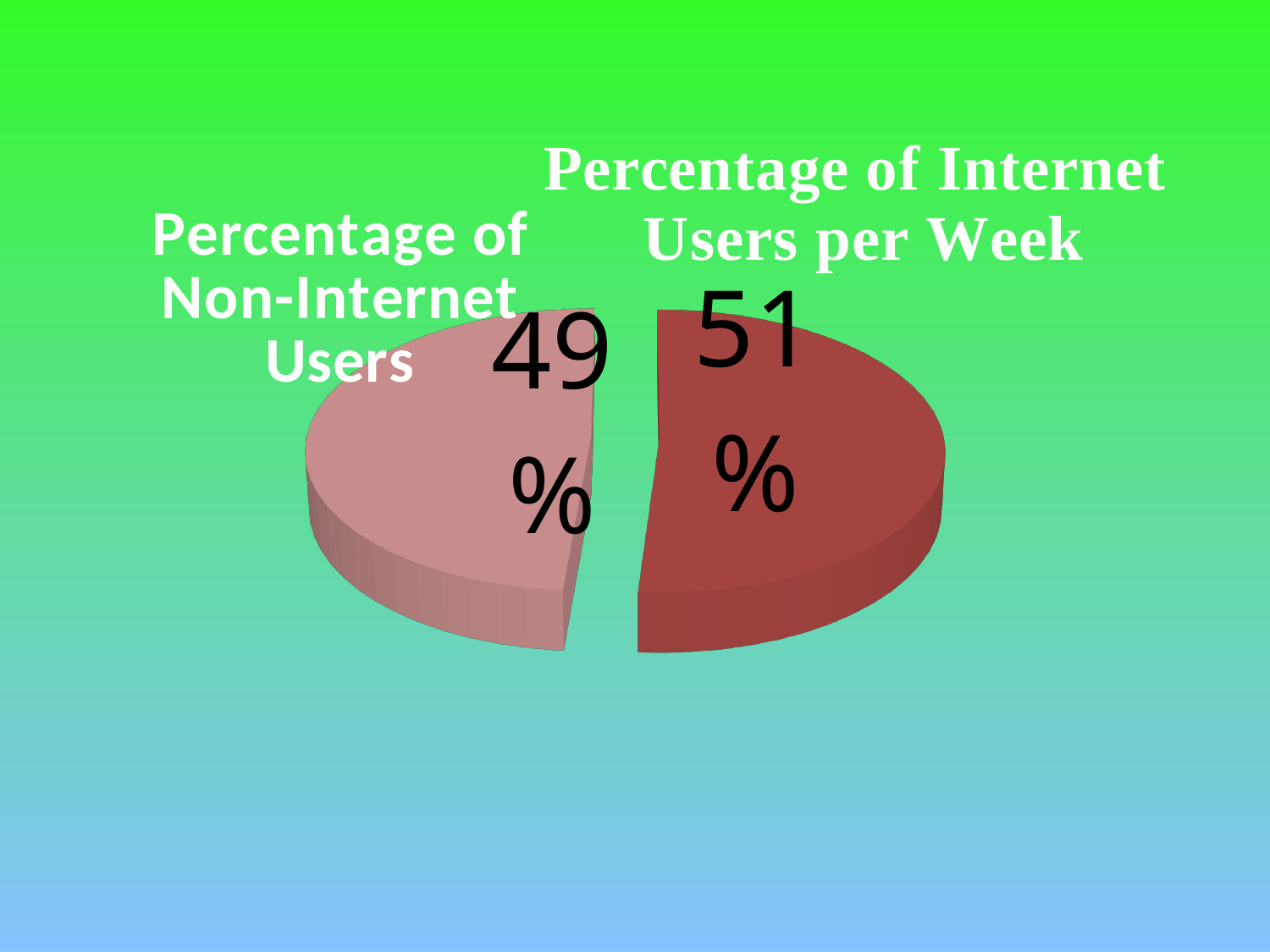
What colour is the Percentage of Internet Users per Week slice? dark red What is the difference between the Internet Users per Week slice and the Non-Internet Users slice? 2% What is the total of the two slices shown in the pie chart? 100% What share of the pie does the Percentage of Non-Internet Users slice represent? 49% What kind of chart is shown on the slide? pie chart How many slices does the pie chart have? 2 Which slice of the pie is the largest? Percentage of Internet Users per Week What percentage is shown for Percentage of Internet Users per Week? 51% Which is larger, the Percentage of Internet Users per Week slice or the Percentage of Non-Internet Users slice? Percentage of Internet Users per Week What percentage is shown for Percentage of Non-Internet Users? 49% What colour is the Percentage of Non-Internet Users slice? light pink Which slice of the pie is the smallest? Percentage of Non-Internet Users